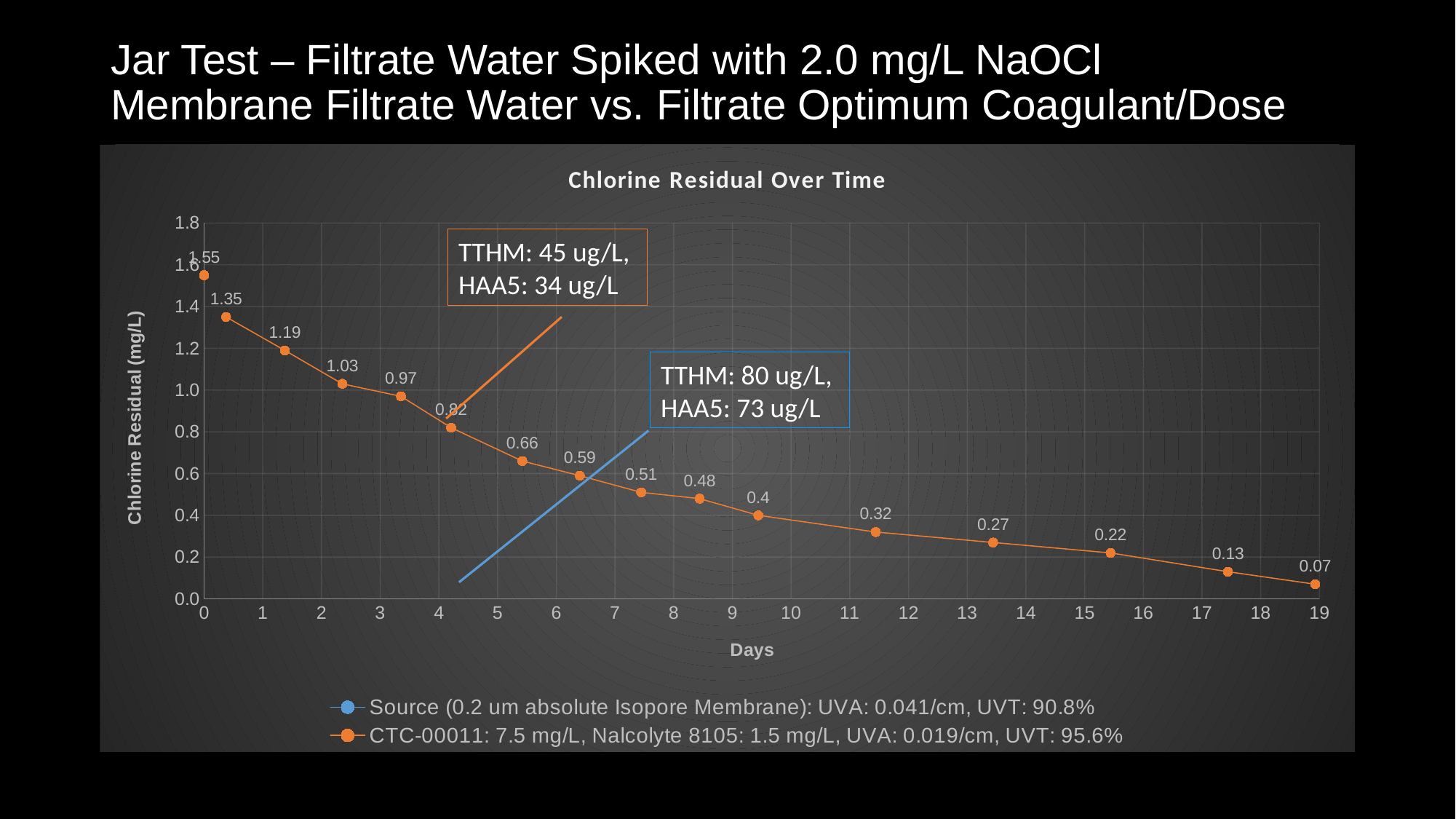
Which is larger on the CTC-00011 series: the value labelled 0.48 or the value labelled 0.4? 0.48 What is the lowest chlorine residual value labelled on the CTC-00011 series? 0.07 What is the difference between the first (1.55) and last (0.07) labelled values on the CTC-00011 series? 1.48 Is the chlorine residual value for the CTC-00011 series at day 19 greater or less than 0.2? less What is the highest chlorine residual value labelled on the CTC-00011 series? 1.55 How many series does the legend list? 2 What kind of chart is shown on the slide? Line chart Do the chlorine residual values for the CTC-00011 series rise or fall as the days increase? Fall What is the label of the y axis? Chlorine Residual (mg/L) What is the title of the chart? Chlorine Residual Over Time What is the difference between the labelled values 1.35 and 1.19 on the CTC-00011 series? 0.16 How many labelled data points are plotted on the CTC-00011 series? 16